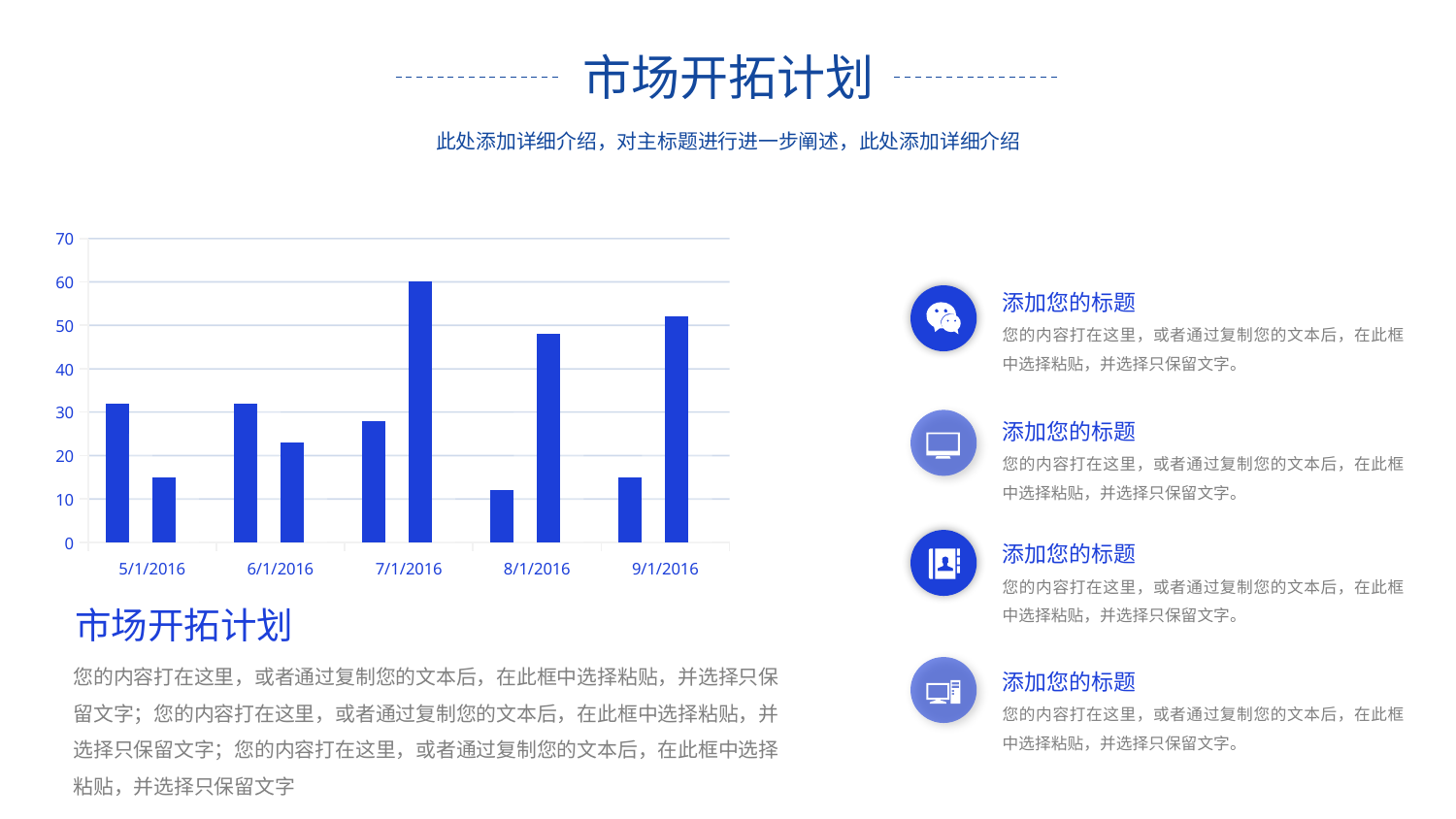
What is the highest value shown on the chart's vertical axis? 70 Which date category contains the tallest bar in the chart? 7/1/2016 For 8/1/2016, which is larger: the first bar or the second bar? the second bar Is the value of the second bar for 6/1/2016 greater or less than 30? less Is the value of the first bar for 5/1/2016 greater or less than 30? greater Which date category contains the shortest bar in the chart? 8/1/2016 Is the value of the second bar for 9/1/2016 greater or less than 50? greater What kind of chart is shown on the slide? bar chart How many date categories are shown on the x axis of the chart? 5 For 5/1/2016, which is larger: the first bar or the second bar? the first bar